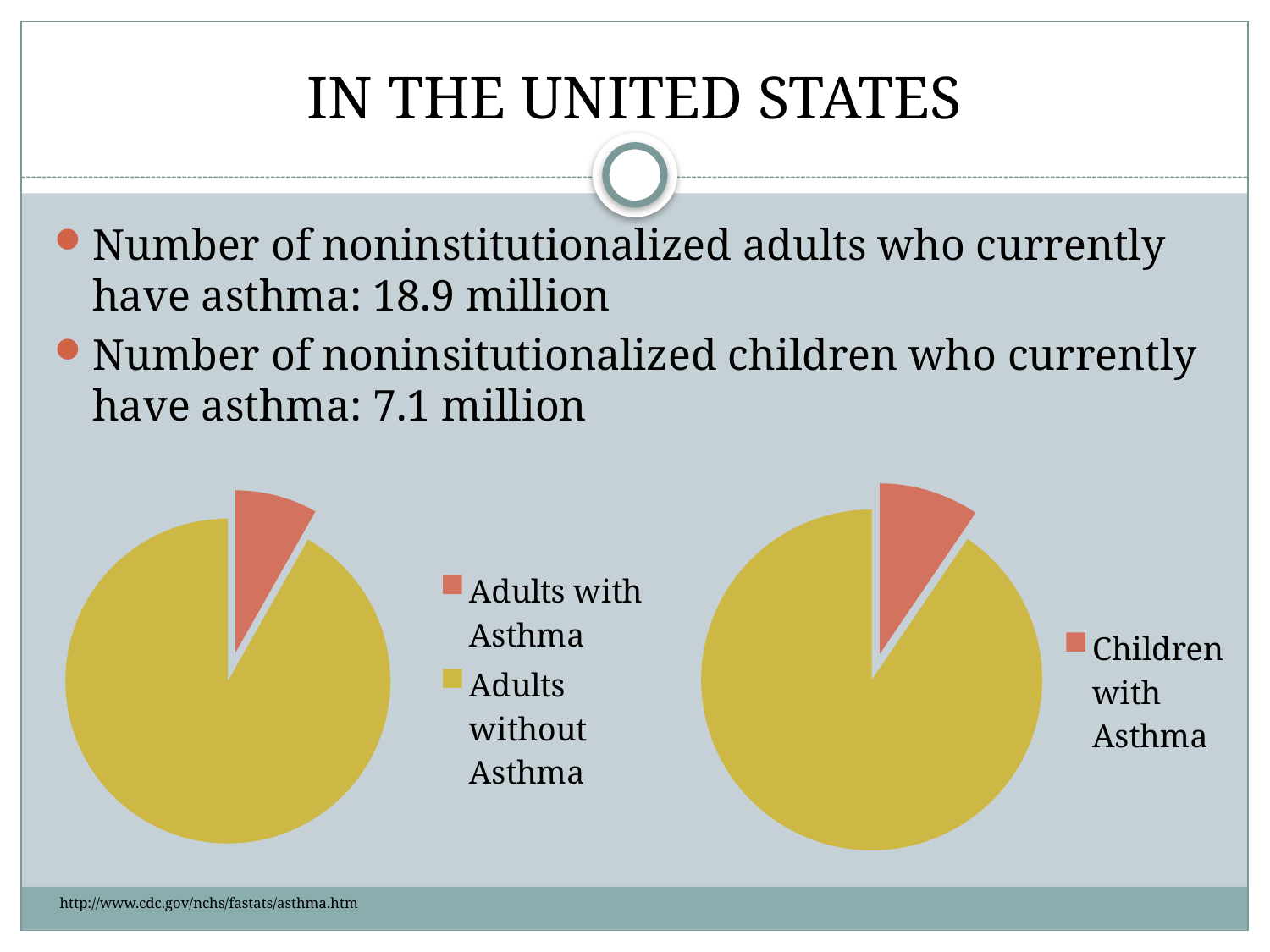
In the left pie chart, what colour is the Adults with Asthma slice? red In the right pie chart, is the Children with Asthma slice more or less than half of the pie? less What kind of chart is the chart on the right of the slide? pie chart In the left pie chart, how many slices does the pie have? 2 In the left pie chart, which category has the largest slice? Adults without Asthma In the left pie chart, which category has the smallest slice? Adults with Asthma In the right pie chart, how many slices does the pie have? 2 In the left pie chart, how many entries does the legend list? 2 In the left pie chart, which slice is larger, Adults with Asthma or Adults without Asthma? Adults without Asthma How many pie charts are shown on the slide? 2 What kind of chart is the chart on the left of the slide? pie chart In the right pie chart, how many entries does the legend list? 1